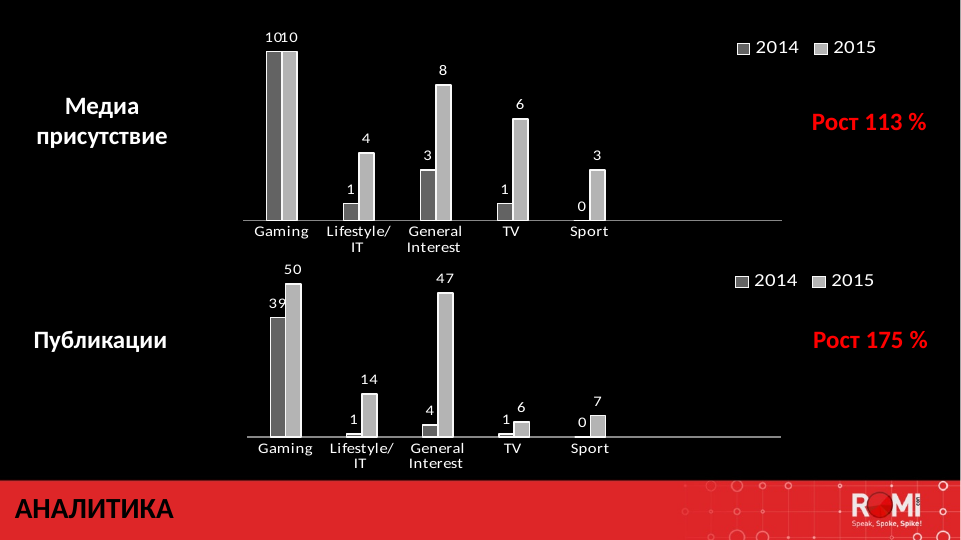
In the bottom chart (Публикации), which is larger: the 2015 value for Gaming or the 2015 value for General Interest? Gaming In the bottom chart (Публикации), what is the difference between the 2015 and 2014 values for Lifestyle/IT? 13 In the top chart (Медиа присутствие), what is the difference between the 2015 and 2014 values for TV? 5 In the bottom chart (Публикации), which category has the lowest 2015 value? TV In the top chart (Медиа присутствие), what is the 2015 value for General Interest? 8 In the top chart (Медиа присутствие), how many series does the legend list? 2 In the top chart (Медиа присутствие), which category has the highest 2015 value? Gaming What type of chart is the top chart (Медиа присутствие)? Bar chart How many categories are shown on the x axis of the bottom chart (Публикации)? 5 In the top chart (Медиа присутствие), what is the 2014 value for Sport? 0 In the bottom chart (Публикации), what is the 2014 value for Gaming? 39 In the bottom chart (Публикации), what is the 2015 value for General Interest? 47